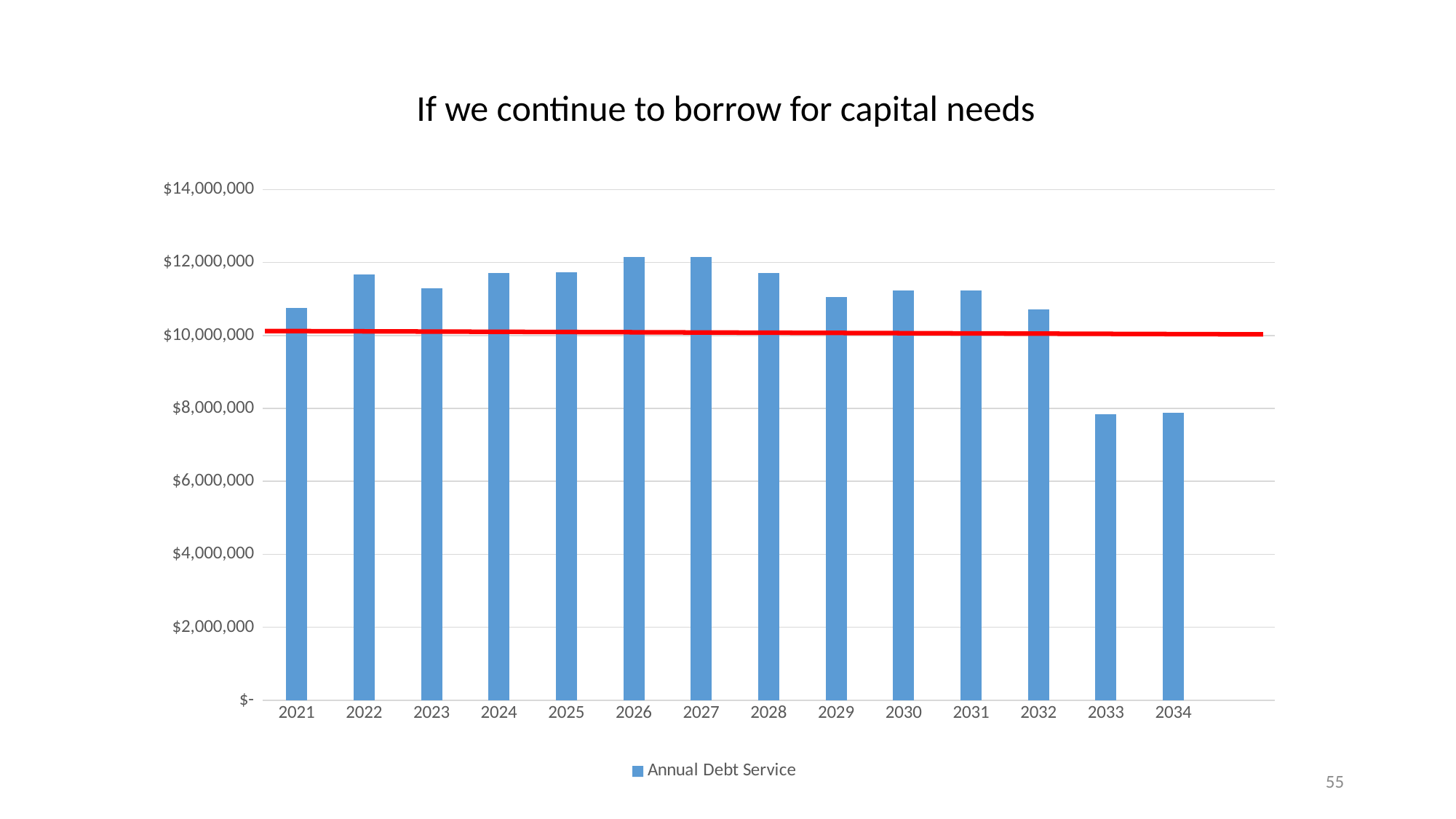
Which year has the larger value, 2032 or 2033? 2032 Is the value for 2033 greater or less than $8,000,000? less What series name appears in the chart's legend? Annual Debt Service What is the title of the chart? If we continue to borrow for capital needs Is the value for 2021 greater or less than $10,000,000? greater Which year has the larger value, 2022 or 2023? 2022 How many years are plotted on the x axis of the chart? 14 What kind of chart is shown on the slide? Bar chart Is the value for 2026 greater or less than $12,000,000? greater How many series does the chart's legend list? 1 Do the values rise or fall from 2031 to 2034? fall